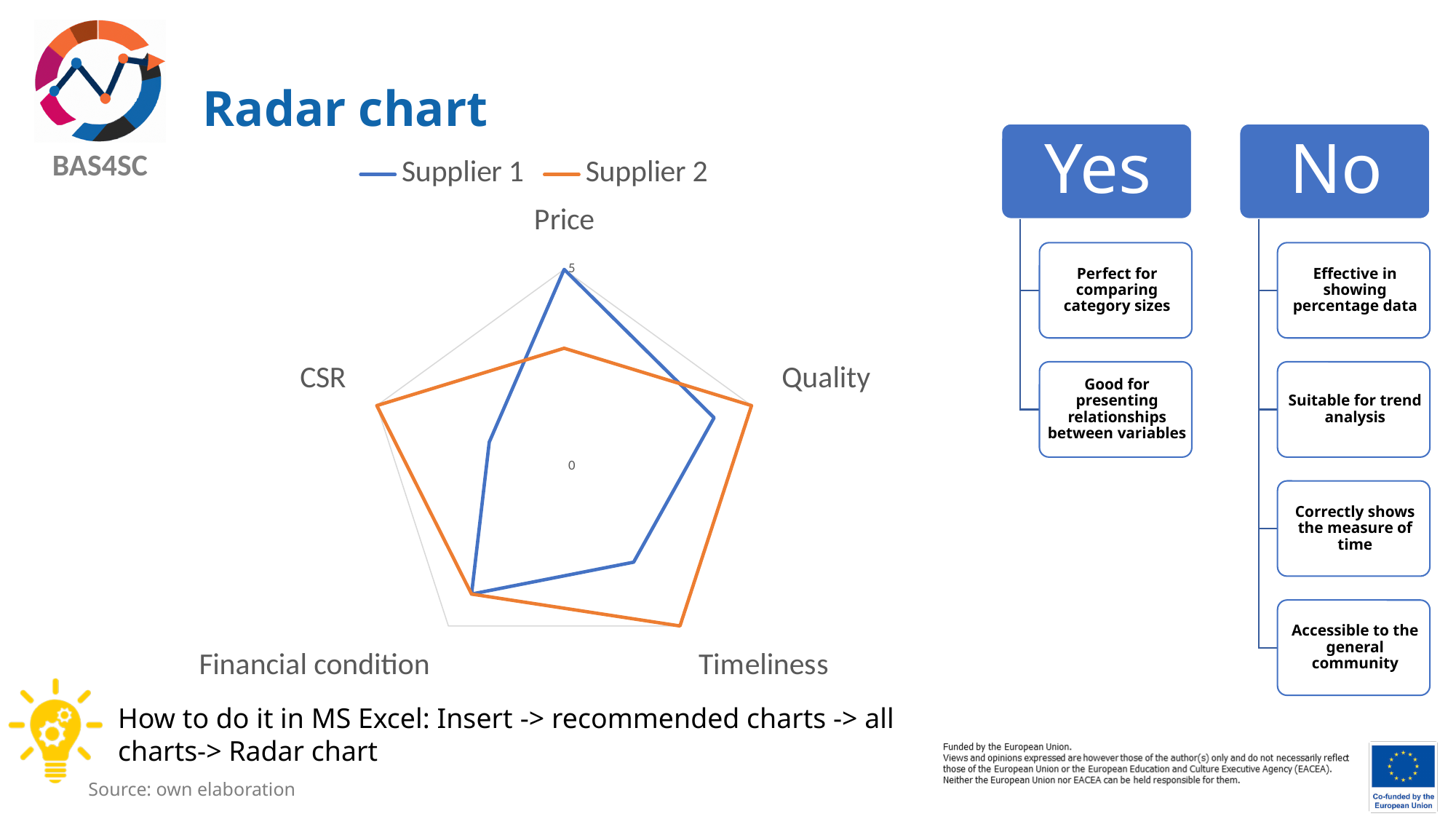
On which axis does Supplier 1 have its lowest value? CSR How many series does the chart's legend list? 2 What is the value for Supplier 2 on the Timeliness axis? 5 What is the value for Supplier 2 on the Quality axis? 5 On which axis does Supplier 1 reach its highest value? Price What kind of chart is shown on the slide? Radar chart On which axis does Supplier 2 have its lowest value? Price How many categories (axes) does the radar chart have? 5 What is the value for Supplier 1 on the Price axis? 5 Which supplier has the higher value on the Price axis? Supplier 1 Which colour represents Supplier 2 in the chart? Orange Which supplier has the higher value on the CSR axis? Supplier 2